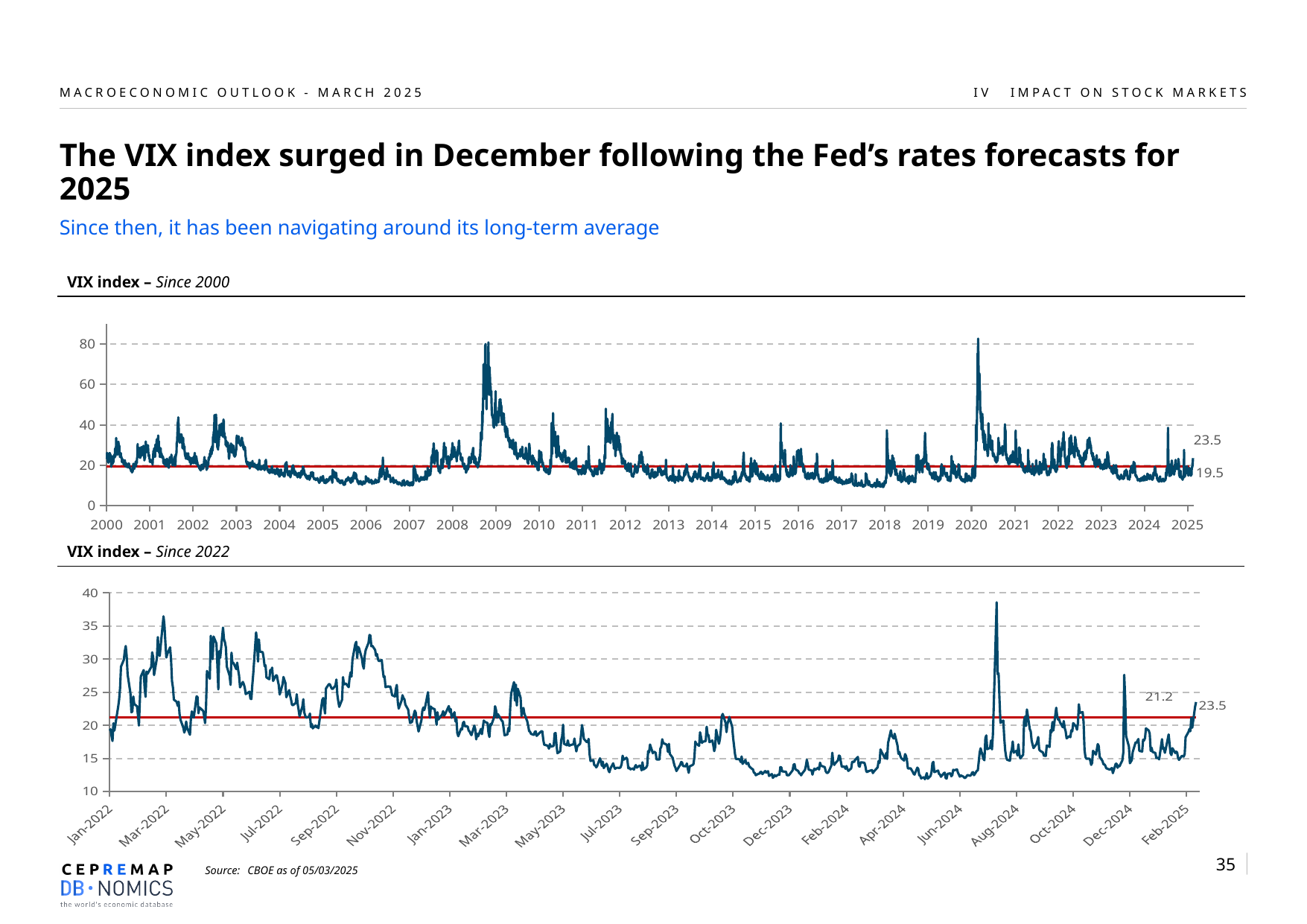
In the 'VIX index – Since 2000' chart, which peak is higher: the one in 2008 or the one in 2011? 2008 In the 'VIX index – Since 2022' chart, is the value around Dec-2023 greater or less than 15? less In the 'VIX index – Since 2000' chart, what value is labelled for the red horizontal average line? 19.5 How many charts are shown on the slide? 2 In the 'VIX index – Since 2000' chart, is the peak value in 2008 greater or less than 60? greater In the 'VIX index – Since 2022' chart, what value is labelled for the red horizontal average line? 21.2 What kind of chart is the 'VIX index – Since 2000' chart? line chart In the 'VIX index – Since 2022' chart, what is the latest value labelled at the end of the line? 23.5 In the 'VIX index – Since 2000' chart, what is the difference between the latest value (23.5) and the average line (19.5)? 4.0 In the 'VIX index – Since 2022' chart, is the peak value in Aug-2024 greater or less than 35? greater In the 'VIX index – Since 2000' chart, what is the latest value labelled at the end of the line? 23.5 What is the difference between the average line in the 'VIX index – Since 2022' chart (21.2) and the average line in the 'VIX index – Since 2000' chart (19.5)? 1.7